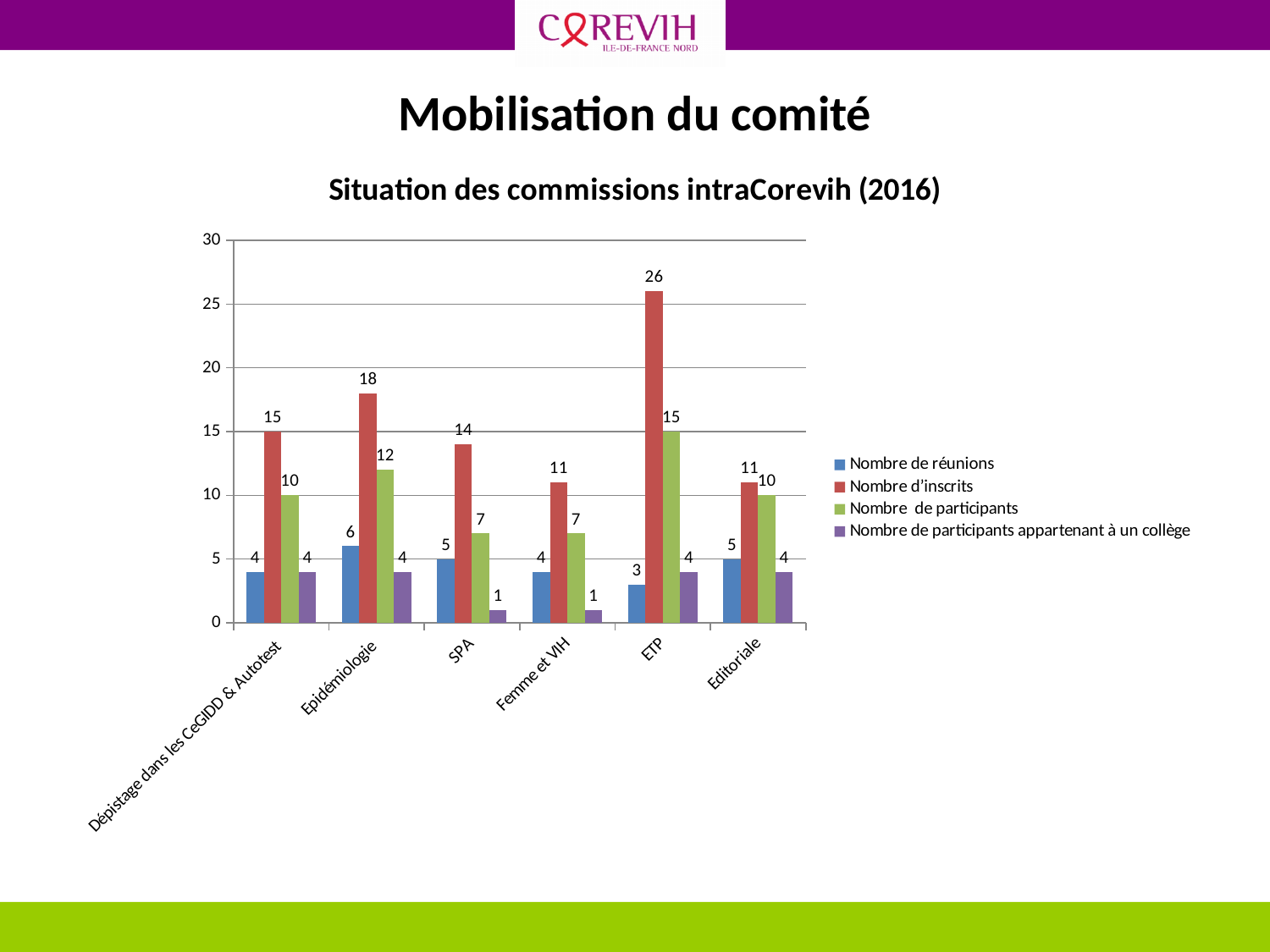
What is the Nombre d'inscrits for ETP? 26 What is the Nombre de participants for SPA? 7 Which commission has the lowest Nombre de réunions? ETP What is the Nombre de réunions for Epidémiologie? 6 Which is larger: the Nombre de participants for Epidémiologie or for Editoriale? Epidémiologie What is the title of the chart? Situation des commissions intraCorevih (2016) Which commission has the highest Nombre d'inscrits? ETP What kind of chart is shown on the slide? Bar chart How many commissions (categories) are shown on the x axis? 6 What is the Nombre de participants appartenant à un collège for Femme et VIH? 1 What is the difference between the Nombre d'inscrits and the Nombre de participants for ETP? 11 How many series does the legend list? 4